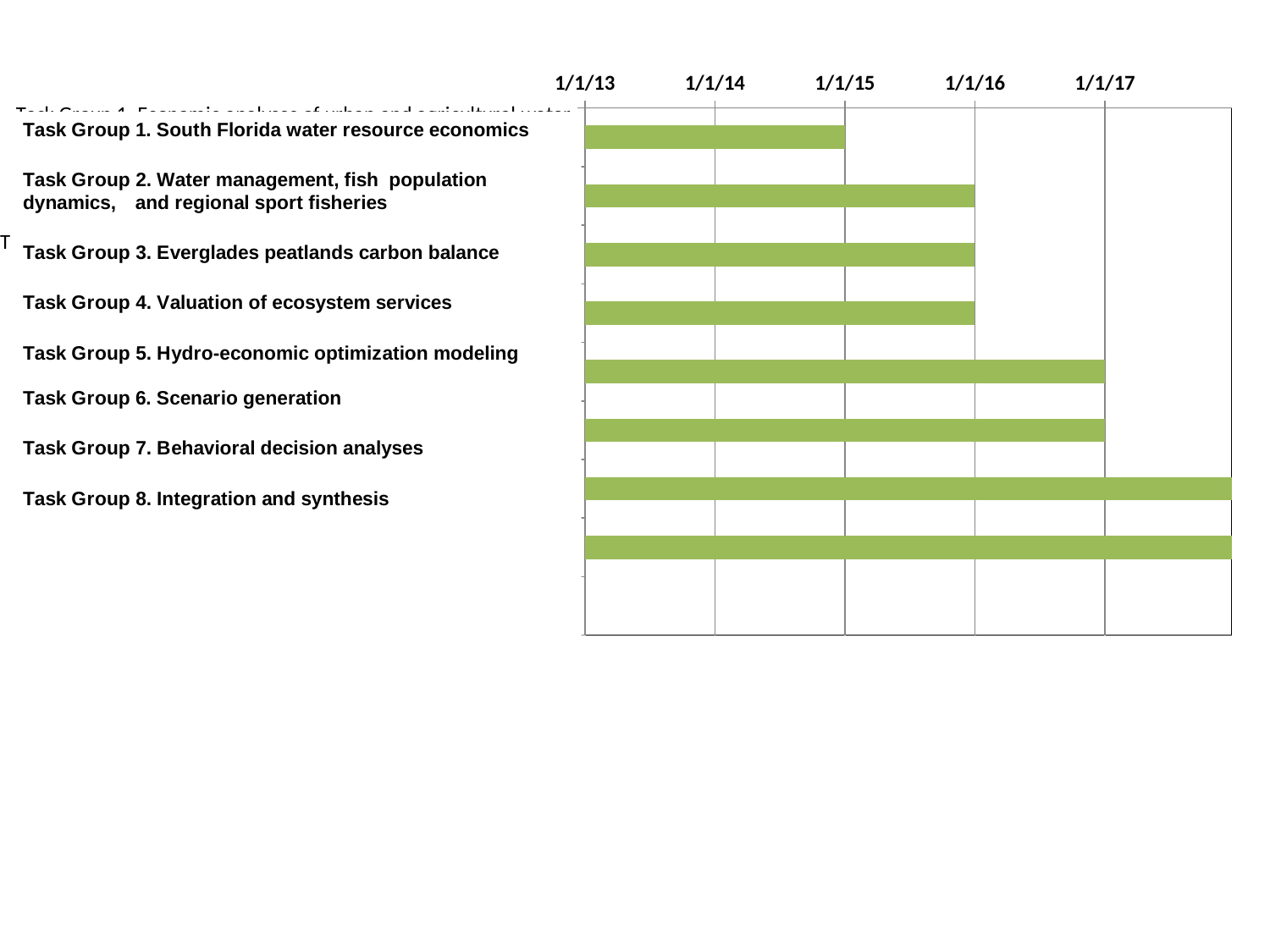
What colour are the bars on the chart? green At what date does the bar for Task Group 1. South Florida water resource economics end? 1/1/15 Does the bar for Task Group 8. Integration and synthesis extend beyond 1/1/17? yes At what date do all of the task group bars start? 1/1/13 Which bar is longer, Task Group 5. Hydro-economic optimization modeling or Task Group 1. South Florida water resource economics? Task Group 5. Hydro-economic optimization modeling At what date does the bar for Task Group 5. Hydro-economic optimization modeling end? 1/1/17 How many date labels are shown along the x axis? 5 Does the bar for Task Group 2. Water management, fish population dynamics, and regional sport fisheries end before or after 1/1/15? after At what date does the bar for Task Group 3. Everglades peatlands carbon balance end? 1/1/16 Which task group has the shortest bar on the chart? Task Group 1. South Florida water resource economics How many task groups (bars) are plotted on the chart? 8 What kind of chart is shown on the slide? bar chart